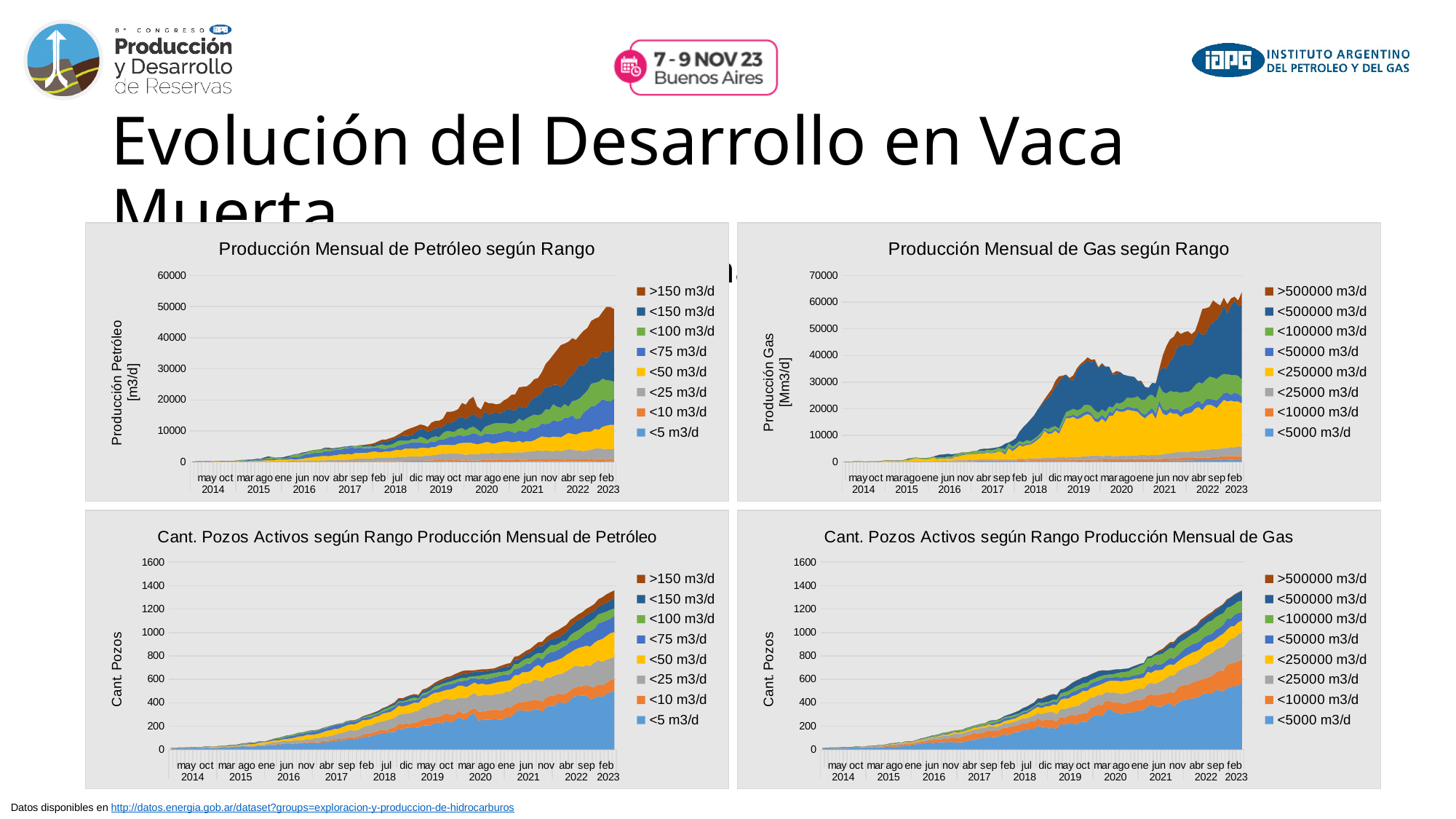
What kind of chart is "Producción Mensual de Petróleo según Rango"? stacked area chart In "Cant. Pozos Activos según Rango Producción Mensual de Petróleo", is the total number of wells in 2023 greater or less than 1200? greater What is the y-axis label of "Producción Mensual de Gas según Rango"? Producción Gas [Mm3/d] In "Producción Mensual de Gas según Rango", is the total production in 2023 greater or less than 50000? greater In "Producción Mensual de Petróleo según Rango", is the total production in 2016 greater or less than 10000? less How many series does the legend of "Producción Mensual de Gas según Rango" list? 8 In "Producción Mensual de Gas según Rango", does total gas production rise or fall between 2019 and 2020? fall How many charts are shown on the slide? 4 What is the first legend entry of "Cant. Pozos Activos según Rango Producción Mensual de Gas"? >500000 m3/d In "Producción Mensual de Petróleo según Rango", does total oil production rise or fall from 2014 to 2023? rise